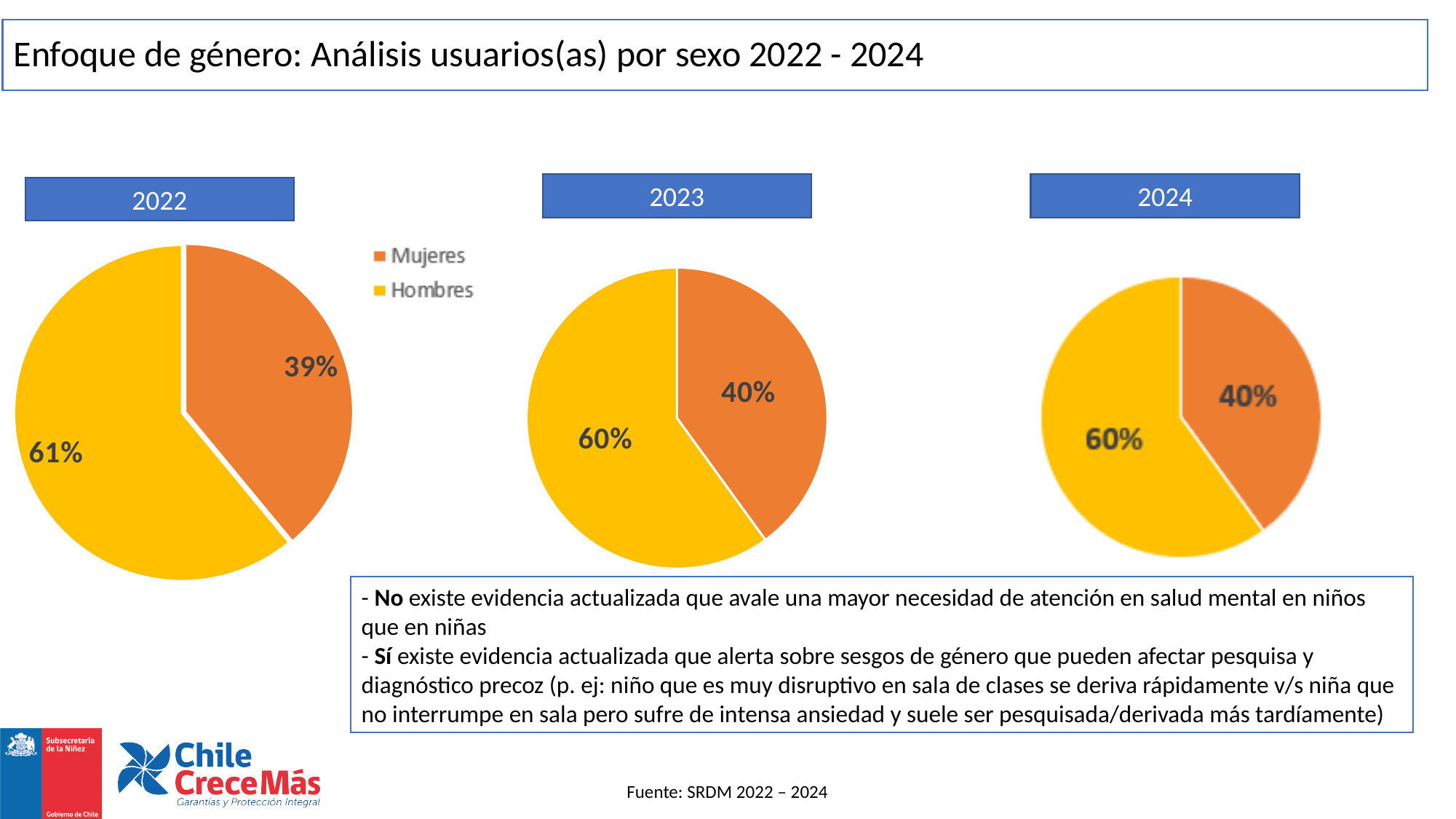
How many slices does the 2024 pie chart have? 2 In the 2023 pie chart, what share is Hombres? 60% In the 2022 pie chart, what share is Hombres? 61% In the 2023 pie chart, is the share for Mujeres larger or smaller than the share for Hombres? smaller How many entries does the legend list? 2 In the 2022 pie chart, what is the difference in percentage points between Hombres and Mujeres? 22 In the 2022 pie chart, what share is Mujeres? 39% What kind of chart is used for 2023? pie chart In the 2024 pie chart, what share is Mujeres? 40% Which colour represents Mujeres in the legend? orange In the 2024 pie chart, which category has the smaller share? Mujeres In the 2022 pie chart, which category has the larger share? Hombres